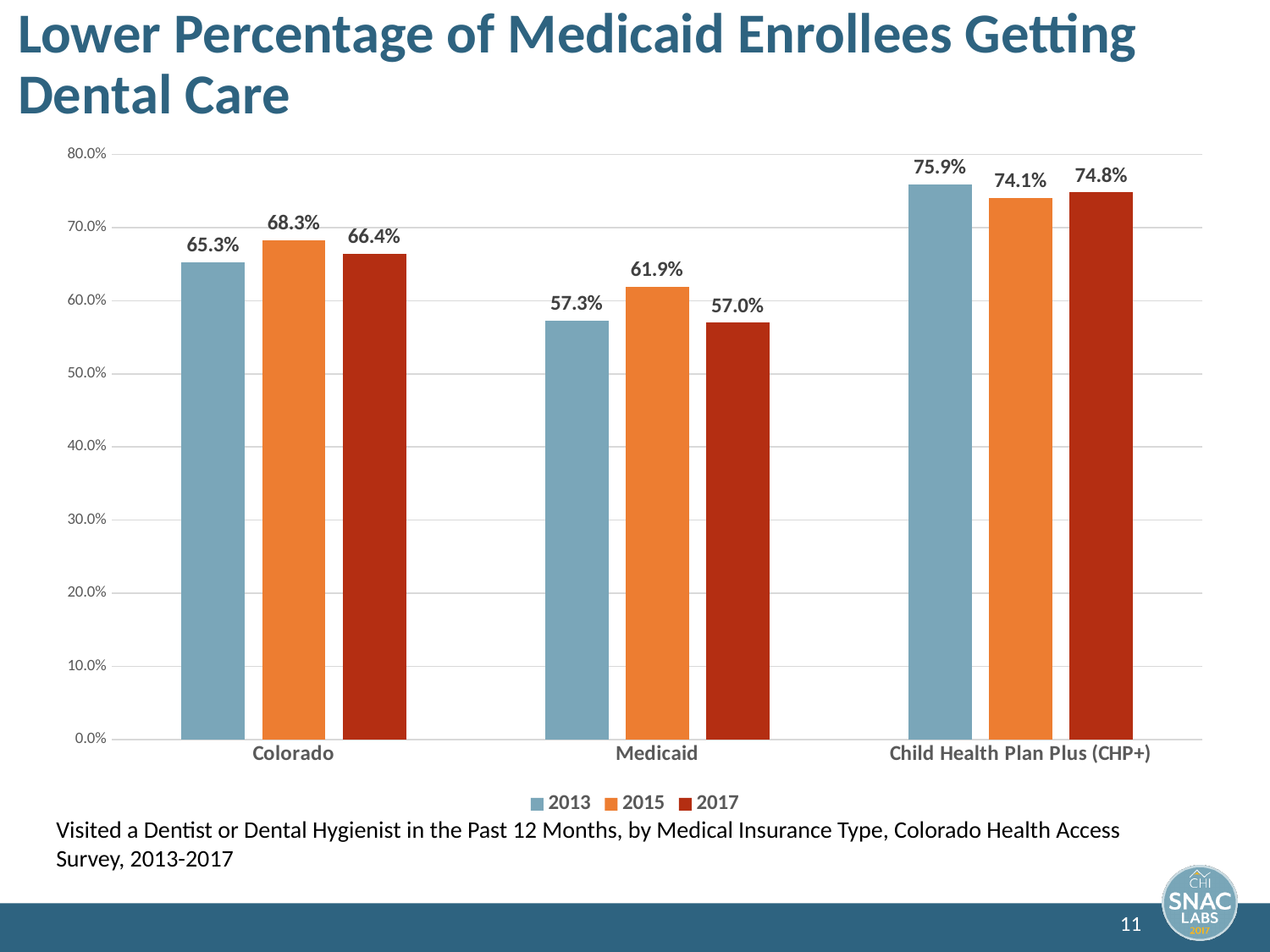
Which series is shown in the darkest red colour in the legend? 2017 What is the value for Medicaid in 2015? 61.9% Which is larger for Colorado: the 2015 value or the 2017 value? 2015 What kind of chart is shown on the slide? Bar chart Which category has the highest value in 2013? Child Health Plan Plus (CHP+) What is the difference between the 2015 and 2017 values for Medicaid? 4.9% How many series does the legend list? 3 What is the value for Child Health Plan Plus (CHP+) in 2017? 74.8% Which category has the lowest value in 2017? Medicaid How many categories are shown on the x axis? 3 What is the difference between the Child Health Plan Plus (CHP+) and Medicaid values in 2013? 18.6% What is the value for Colorado in 2013? 65.3%